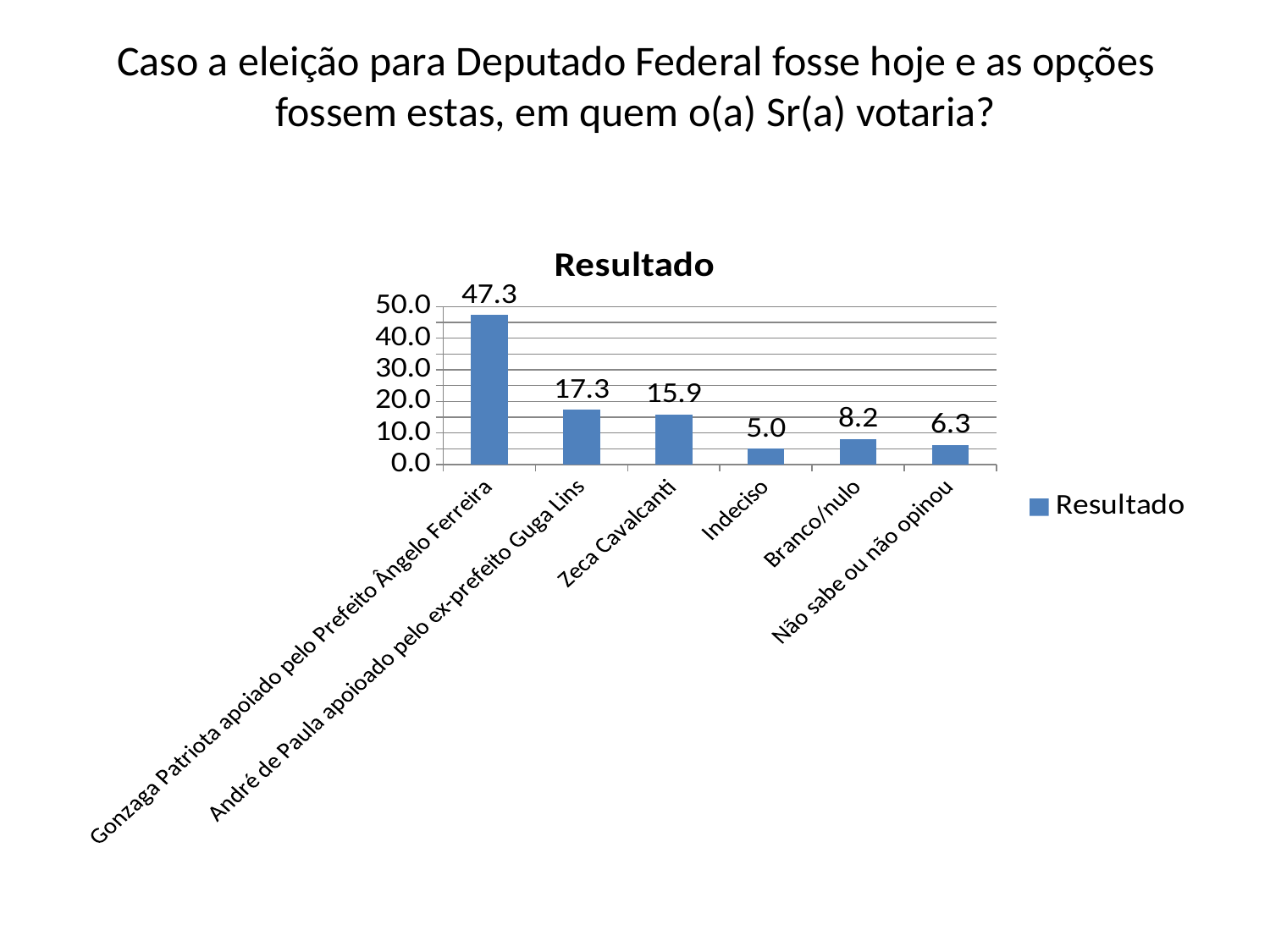
Is the value for Gonzaga Patriota apoiado pelo Prefeito Ângelo Ferreira greater or less than 40.0? greater What kind of chart is shown? bar chart Which is larger, the value for Branco/nulo or the value for Não sabe ou não opinou? Branco/nulo Which category has the lowest value? Indeciso What is the title of the chart? Resultado Which category has the highest value? Gonzaga Patriota apoiado pelo Prefeito Ângelo Ferreira What is the value for André de Paula apoioado pelo ex-prefeito Guga Lins? 17.3 What is the value for Branco/nulo? 8.2 What is the difference between the values for Gonzaga Patriota apoiado pelo Prefeito Ângelo Ferreira and André de Paula apoioado pelo ex-prefeito Guga Lins? 30.0 What is the value for Indeciso? 5.0 How many categories are shown on the x axis? 6 What is the value for Zeca Cavalcanti? 15.9